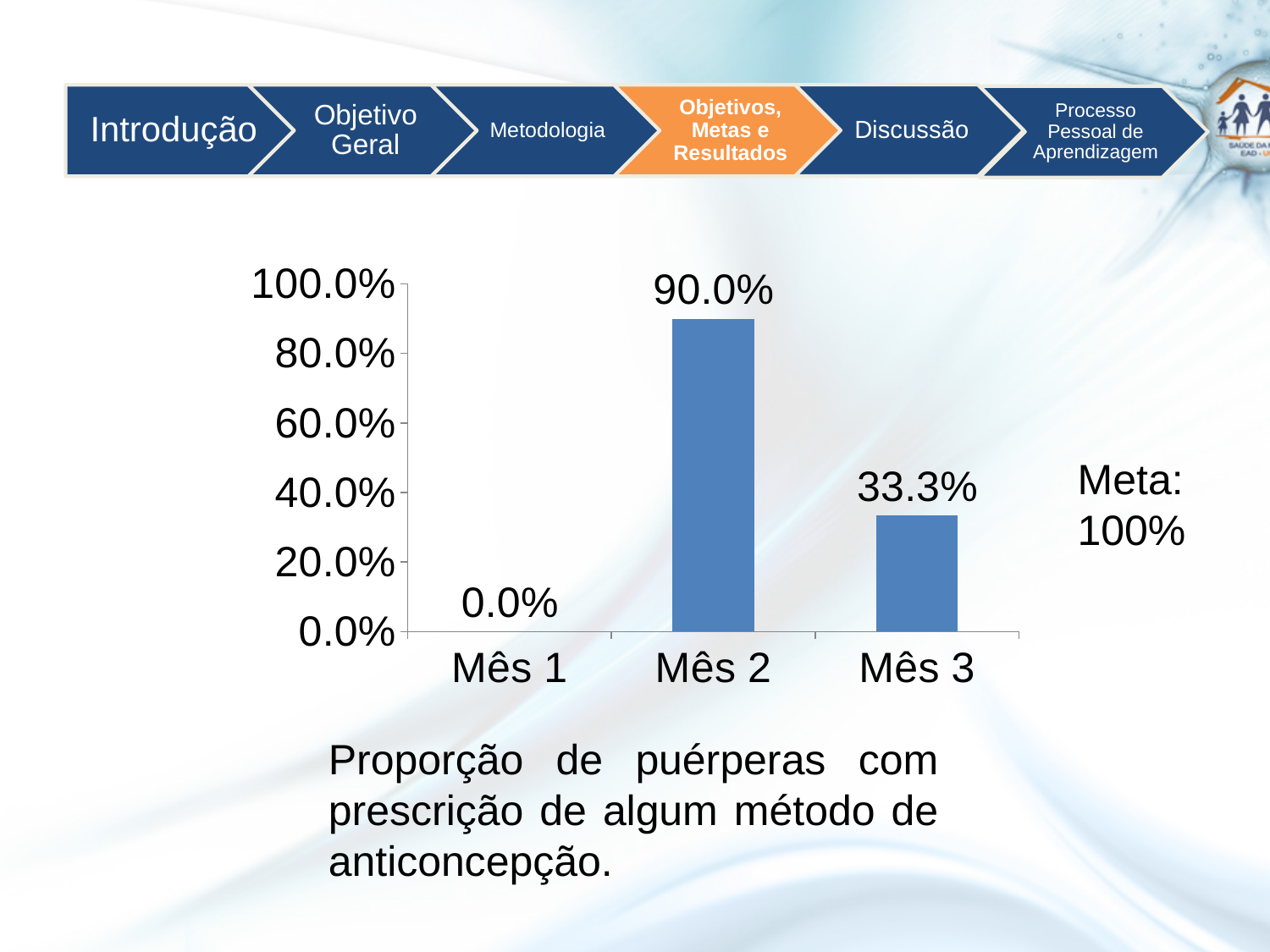
What is the value for Mês 3? 33.3% How many months are shown on the x axis? 3 What is the value for Mês 2? 90.0% Is the value for Mês 3 greater or less than 40.0%? less What is the difference between the values for Mês 2 and Mês 3? 56.7% What is the value for Mês 1? 0.0% Which is larger, the value for Mês 2 or the value for Mês 3? Mês 2 What kind of chart is shown on the slide? bar chart What target (Meta) is stated next to the chart? 100% Which month has the highest value? Mês 2 Which month has the lowest value? Mês 1 Is the value for Mês 2 greater or less than 80.0%? greater